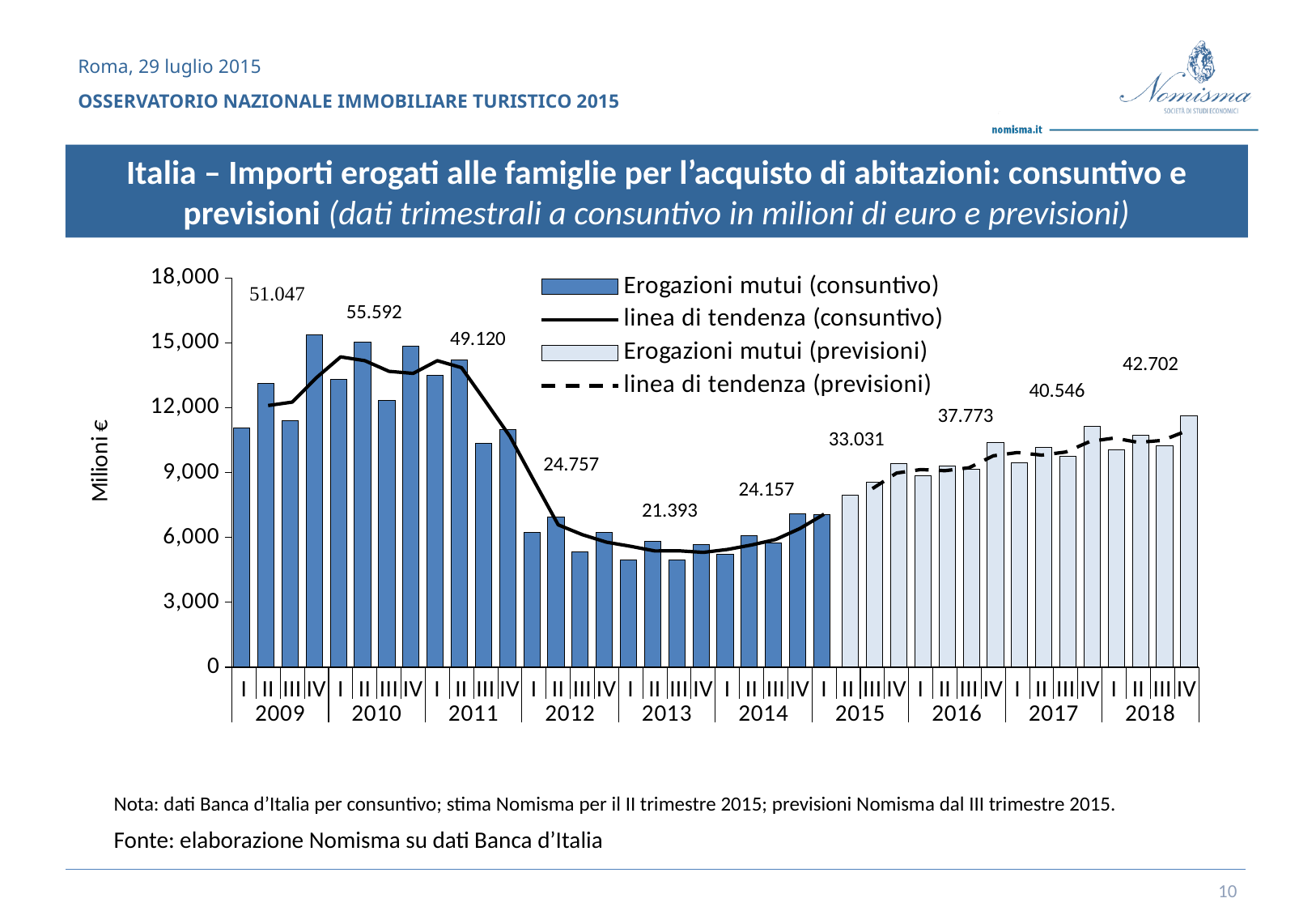
What annual total is labelled above the 2013 bars? 21.393 How many series does the legend list? 4 Is the value for quarter III of 2012 greater or less than 6,000? less Which labelled annual total is larger, 2012 or 2014? 2012 What annual total is labelled above the 2018 bars? 42.702 What is the difference between the labelled annual totals for 2018 and 2017? 2.156 Which year has the highest labelled annual total? 2010 What annual total is labelled above the 2010 bars? 55.592 What is the difference between the labelled annual totals for 2010 and 2009? 4.545 Is the value for quarter I of 2010 greater or less than 12,000? greater Which year has the lowest labelled annual total? 2013 How many years are shown on the x axis? 10